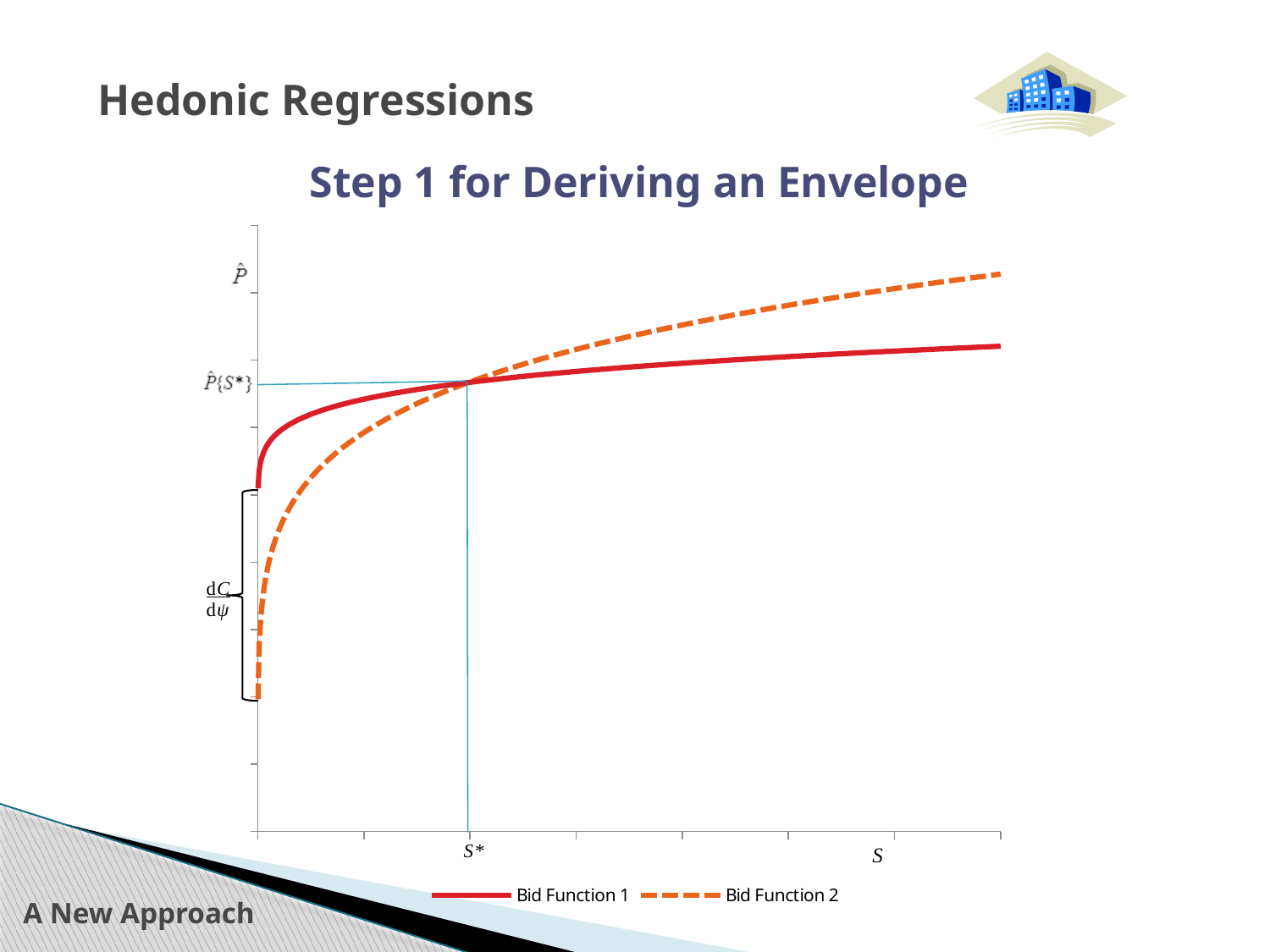
What is the title of the chart? Step 1 for Deriving an Envelope Does Bid Function 1 rise or fall as S increases? Rise What kind of chart is shown on the slide? Line chart At the left end of the chart, which series is higher, Bid Function 1 or Bid Function 2? Bid Function 1 At the right end of the chart, which series is higher, Bid Function 1 or Bid Function 2? Bid Function 2 How many series does the legend list? 2 Which series starts at a lower value on the vertical axis at the left edge of the chart? Bid Function 2 What label is given on the vertical axis at the point where the two curves cross? P̂{S*} Does Bid Function 2 rise or fall as S increases? Rise Which series is drawn as a dashed line? Bid Function 2 At what value of S do the two bid functions cross? S* What is the label on the horizontal axis? S